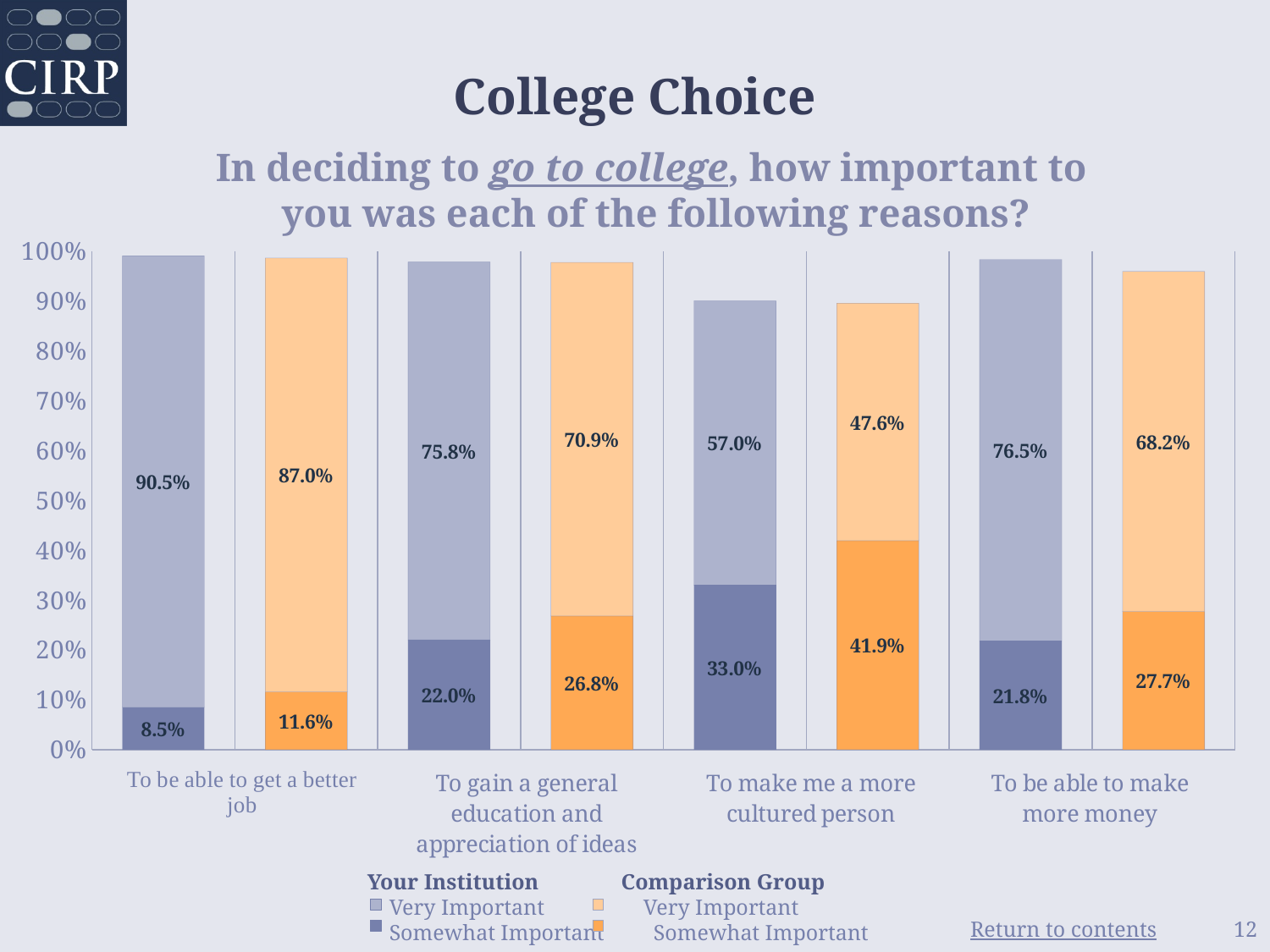
What is the difference between the Your Institution and Comparison Group Very Important percentages for "To make me a more cultured person"? 9.4% Which reason has the lowest Very Important percentage for the Comparison Group? To make me a more cultured person What is the combined Very Important and Somewhat Important total for Your Institution for "To make me a more cultured person"? 90.0% What percentage of the Comparison Group rated "To make me a more cultured person" as Somewhat Important? 41.9% What type of chart is shown on the slide? Stacked bar chart How many series does the chart legend list? 4 How many reasons (categories) are shown on the x axis of the chart? 4 Which reason has the highest Very Important percentage for Your Institution? To be able to get a better job For "To gain a general education and appreciation of ideas", which group has the larger Somewhat Important percentage, Your Institution or the Comparison Group? Comparison Group What percentage of Your Institution students rated "To be able to get a better job" as Very Important? 90.5% What is the Very Important percentage for the Comparison Group for "To be able to make more money"? 68.2% What is the combined Very Important and Somewhat Important total for the Comparison Group for "To be able to get a better job"? 98.6%